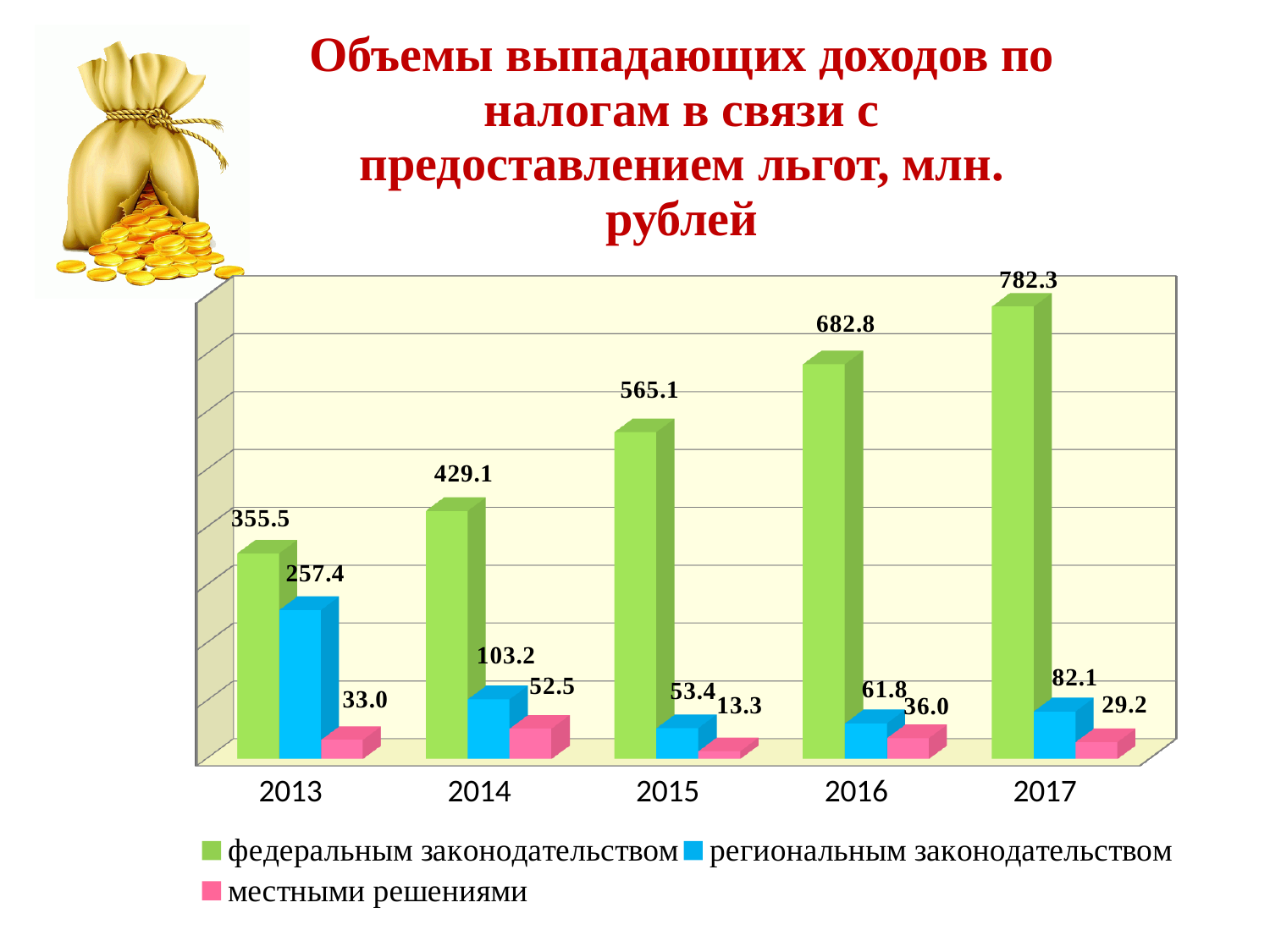
What is the value for региональным законодательством in 2013? 257.4 Which colour represents местными решениями in the legend? pink Which is larger in 2014: региональным законодательством or местными решениями? региональным законодательством In which year is the value for местными решениями the lowest? 2015 What is the value for федеральным законодательством in 2017? 782.3 Do the values for федеральным законодательством rise or fall from 2013 to 2017? rise How many series does the legend list? 3 What is the difference between the федеральным законодательством values for 2017 and 2016? 99.5 In which year is the value for федеральным законодательством the highest? 2017 What is the value for местными решениями in 2015? 13.3 What kind of chart is shown on the slide? bar chart How many years are shown on the x axis? 5